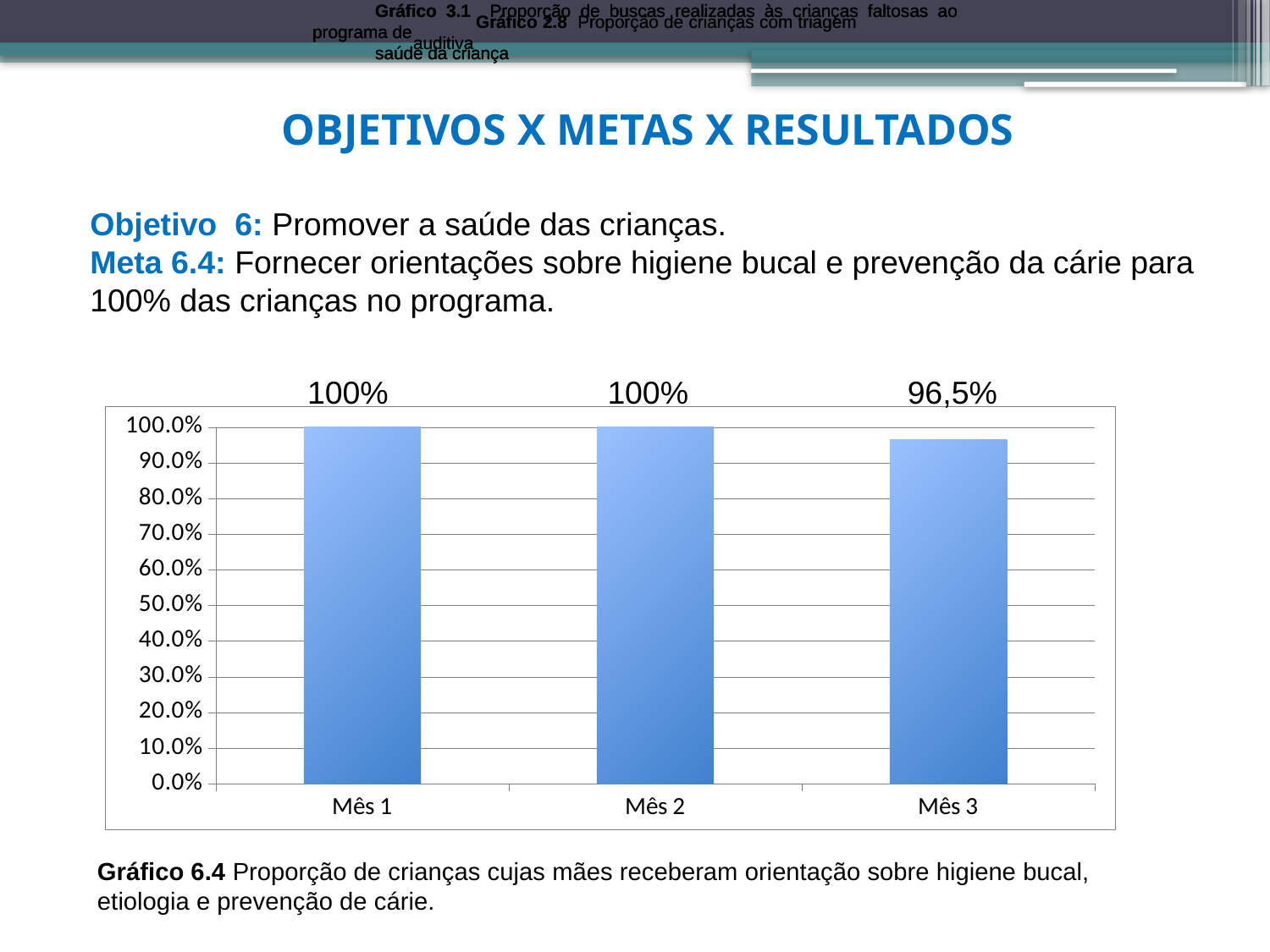
What is the value for Mês 1? 100% What is the difference between the values for Mês 1 and Mês 3? 3,5% What is the value for Mês 3? 96,5% What kind of chart is shown on the slide? bar chart Is the value for Mês 3 greater or less than 90.0%? greater What is the label of the first category on the x axis? Mês 1 What is the value for Mês 2? 100% Do the values rise or fall from Mês 2 to Mês 3? fall Which is larger, the value for Mês 2 or the value for Mês 3? Mês 2 What is the number of the chart given in the caption below it? Gráfico 6.4 Which month has the lowest value? Mês 3 How many months are shown on the x axis of the chart? 3